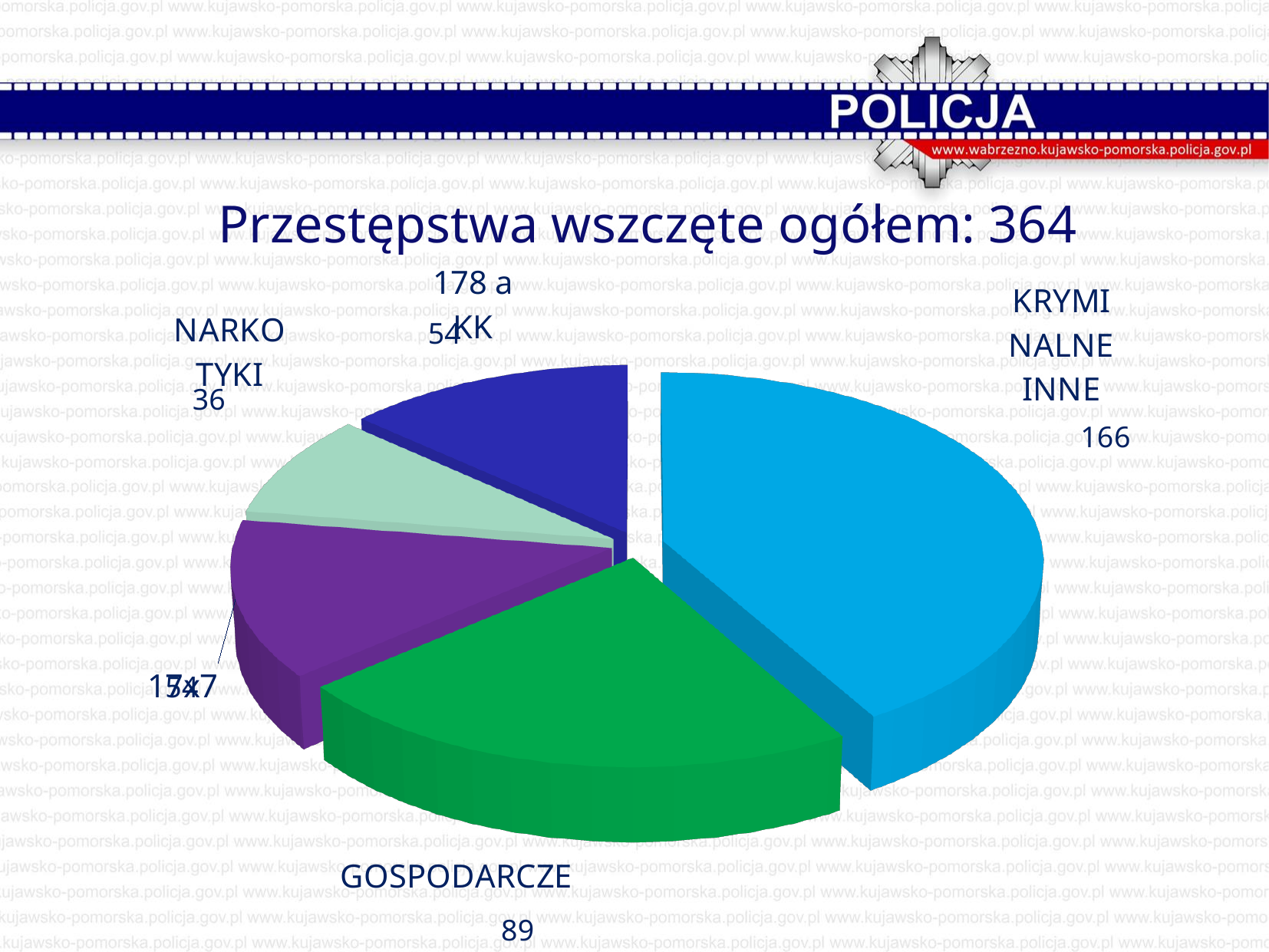
What is the value for 178 a KK? 54 Which is larger, GOSPODARCZE or 178 a KK? GOSPODARCZE What is the value for KRYMINALNE INNE? 166 Which is larger, NARKOTYKI or 178 a KK? 178 a KK How many slices does the pie chart have? 5 What is the difference between the values for 178 a KK and NARKOTYKI? 18 What is the difference between the values for KRYMINALNE INNE and GOSPODARCZE? 77 What is the value for GOSPODARCZE? 89 Which category has the largest slice of the pie? KRYMINALNE INNE What kind of chart is shown on the slide? pie chart According to the chart title, what is the total number of crimes initiated (Przestępstwa wszczęte ogółem)? 364 What is the value for NARKOTYKI? 36